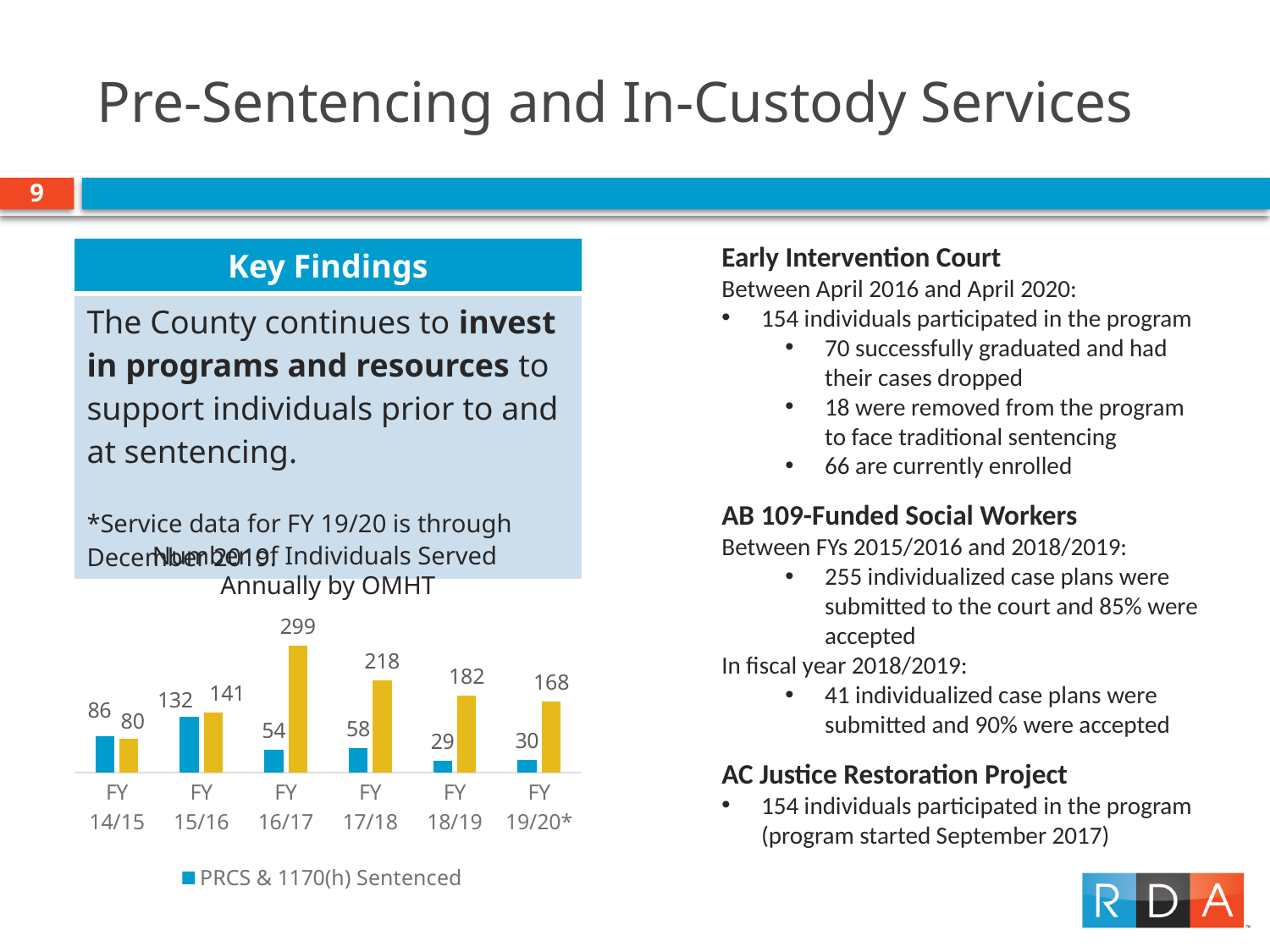
What is the difference between the yellow bar and the PRCS & 1170(h) Sentenced bar in FY 17/18? 160 What is the value of the yellow bar for FY 16/17? 299 Does the PRCS & 1170(h) Sentenced value rise or fall from FY 15/16 to FY 18/19? Fall Which is larger in FY 14/15: the PRCS & 1170(h) Sentenced bar or the yellow bar? PRCS & 1170(h) Sentenced What is the value of the yellow bar for FY 19/20*? 168 What is the value for PRCS & 1170(h) Sentenced in FY 14/15? 86 What is the title of the chart? Number of Individuals Served Annually by OMHT What kind of chart is shown on the slide? Bar chart How many fiscal years are shown on the x axis of the chart? 6 In which fiscal year is the PRCS & 1170(h) Sentenced value lowest? FY 18/19 What is the value for PRCS & 1170(h) Sentenced in FY 16/17? 54 In which fiscal year is the yellow bar highest? FY 16/17